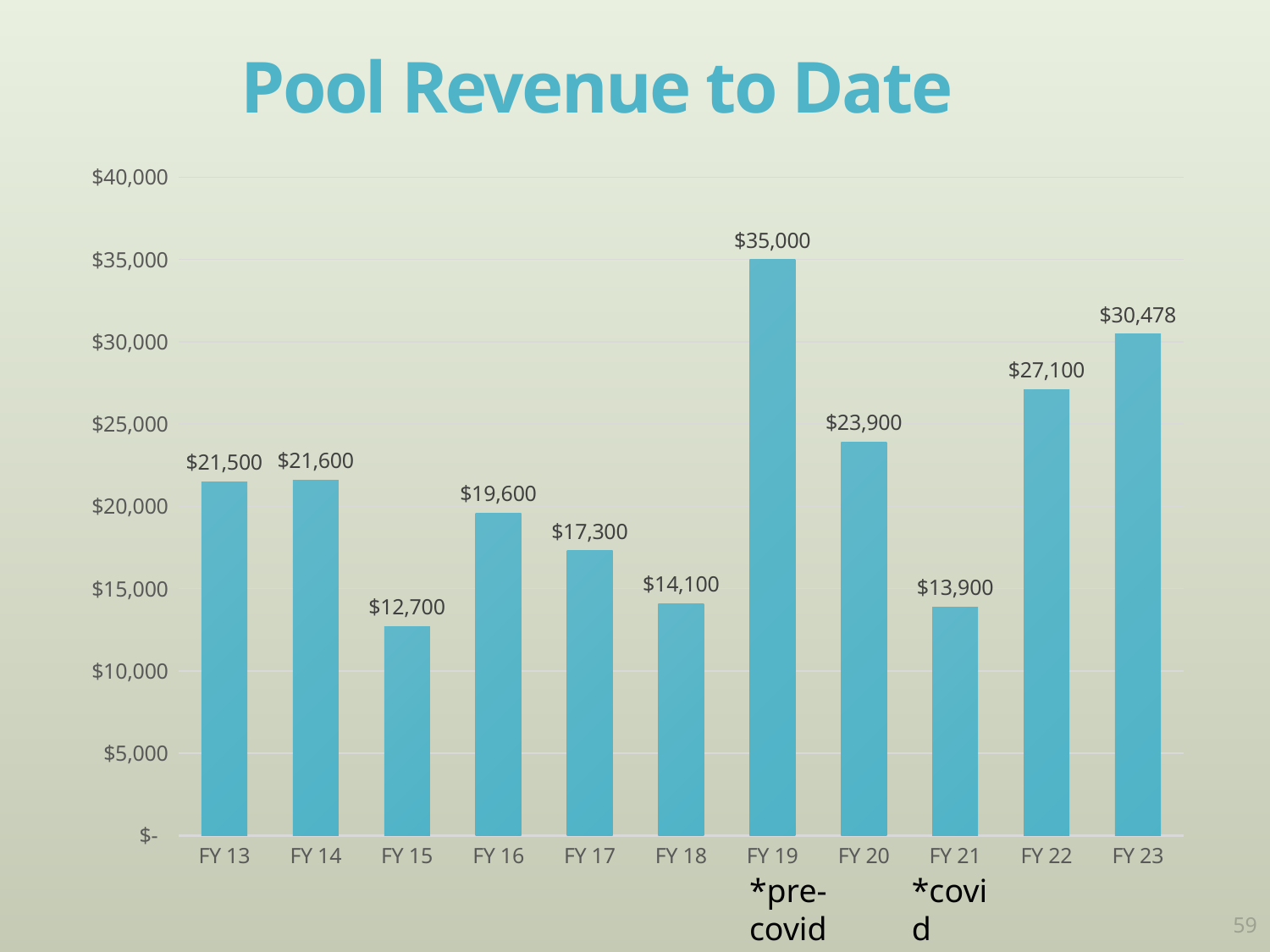
What kind of chart is shown on the slide? bar chart What is the pool revenue for FY 23? $30,478 Is the pool revenue for FY 18 greater or less than $15,000? less What is the title of the chart? Pool Revenue to Date What is the difference in pool revenue between FY 19 and FY 20? $11,100 What is the pool revenue for FY 19? $35,000 Which has higher pool revenue, FY 16 or FY 17? FY 16 Which fiscal year has the highest pool revenue? FY 19 What is the pool revenue for FY 15? $12,700 How many fiscal years are shown on the chart? 11 Which fiscal year has the lowest pool revenue? FY 15 What is the difference in pool revenue between FY 22 and FY 21? $13,200